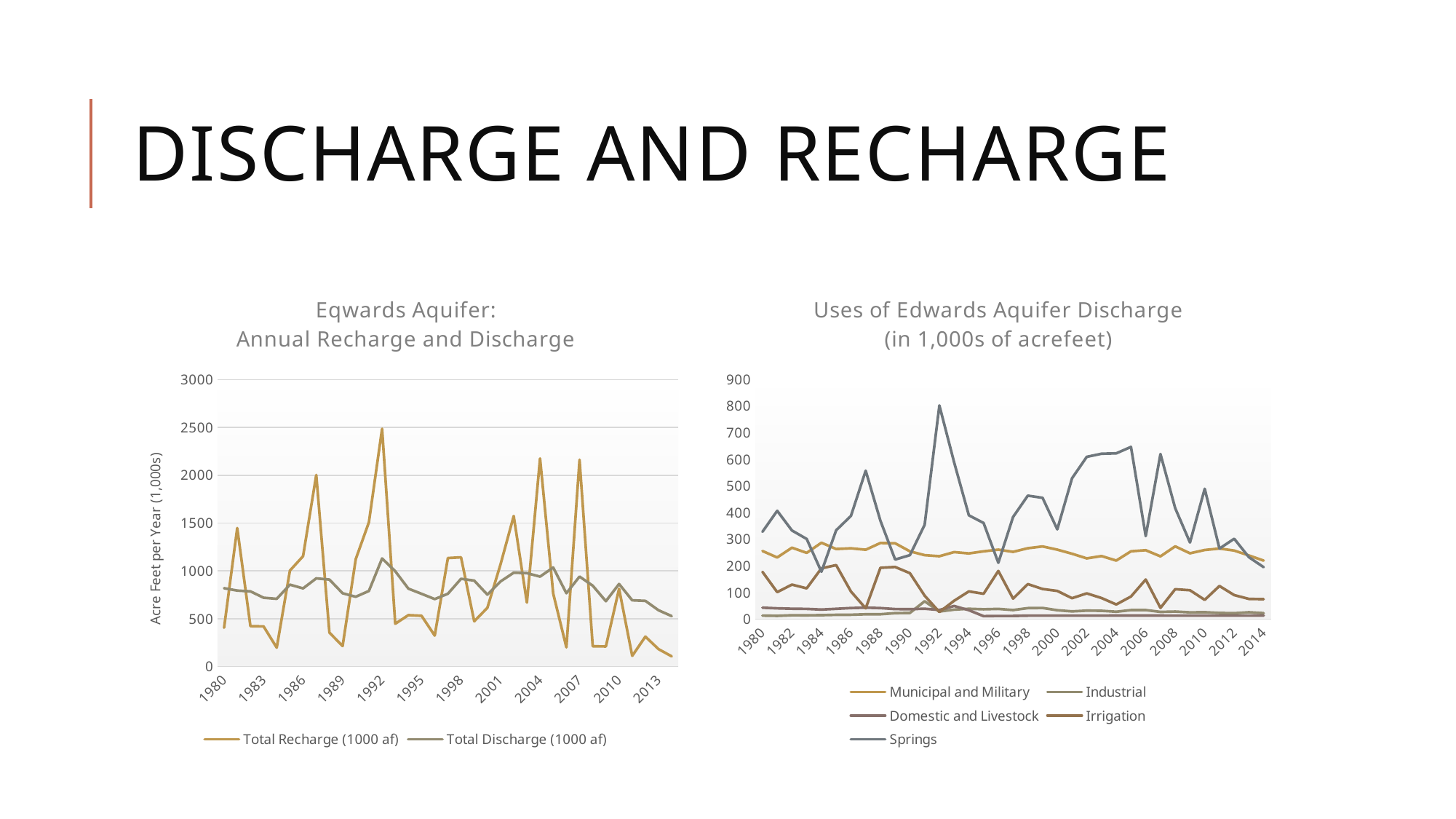
How many series does the legend of the right chart, 'Uses of Edwards Aquifer Discharge', list? 5 In the right chart, 'Uses of Edwards Aquifer Discharge', which series is larger in 2014, Springs or Irrigation? Springs What kind of chart is the left chart, 'Eqwards Aquifer: Annual Recharge and Discharge'? Line chart In the left chart, 'Eqwards Aquifer: Annual Recharge and Discharge', in which year does Total Recharge reach its highest peak? 1992 How many series does the legend of the left chart, 'Eqwards Aquifer: Annual Recharge and Discharge', list? 2 In the right chart, 'Uses of Edwards Aquifer Discharge', is the Springs value in 1992 greater or less than 700? greater In the left chart, 'Eqwards Aquifer: Annual Recharge and Discharge', is the Total Recharge value in 1992 greater or less than 2000? greater In the right chart, 'Uses of Edwards Aquifer Discharge', which series has the highest value in 1992? Springs In the left chart, 'Eqwards Aquifer: Annual Recharge and Discharge', which series is larger in 1992, Total Recharge or Total Discharge? Total Recharge In the right chart, 'Uses of Edwards Aquifer Discharge', is the Municipal and Military value in 2014 greater or less than 300? less What is the y-axis title of the left chart, 'Eqwards Aquifer: Annual Recharge and Discharge'? Acre Feet per Year (1,000s) In the left chart, 'Eqwards Aquifer: Annual Recharge and Discharge', does Total Discharge generally rise or fall from 2007 to the end of the series? fall